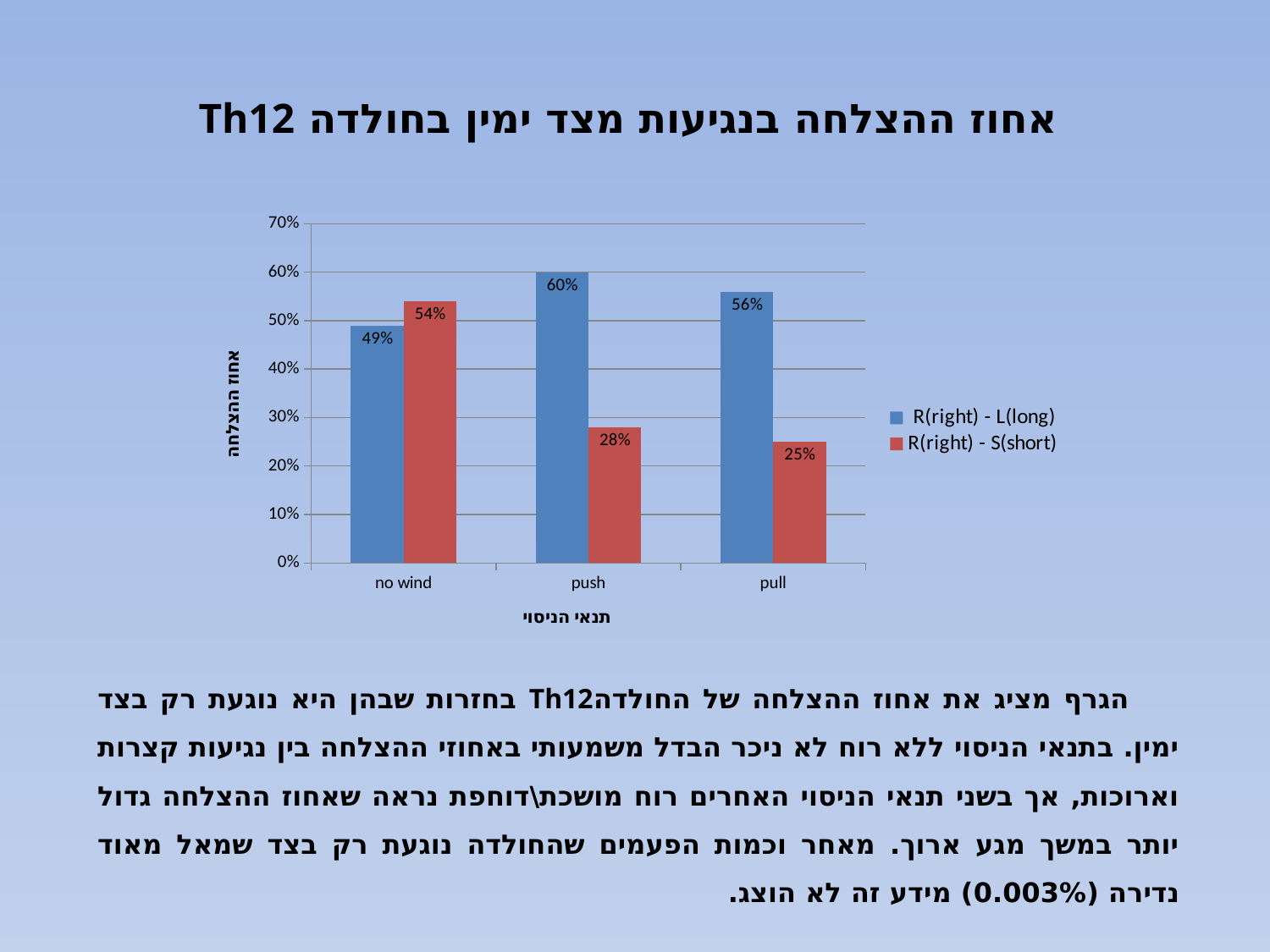
What is the value for R(right) - L(long) under the push condition? 60% What is the difference between R(right) - L(long) and R(right) - S(short) under the push condition? 32% Is the value for R(right) - L(long) under the pull condition greater or less than 50%? greater What kind of chart is shown on the slide? bar chart Under the no wind condition, which series has the larger value, R(right) - L(long) or R(right) - S(short)? R(right) - S(short) How many experimental conditions are shown on the x axis? 3 What is the value for R(right) - S(short) under the pull condition? 25% Which condition has the lowest value for R(right) - S(short)? pull What is the label of the x axis? תנאי הניסוי What is the value for R(right) - S(short) under the no wind condition? 54% Which condition has the highest value for R(right) - L(long)? push How many series does the legend list? 2